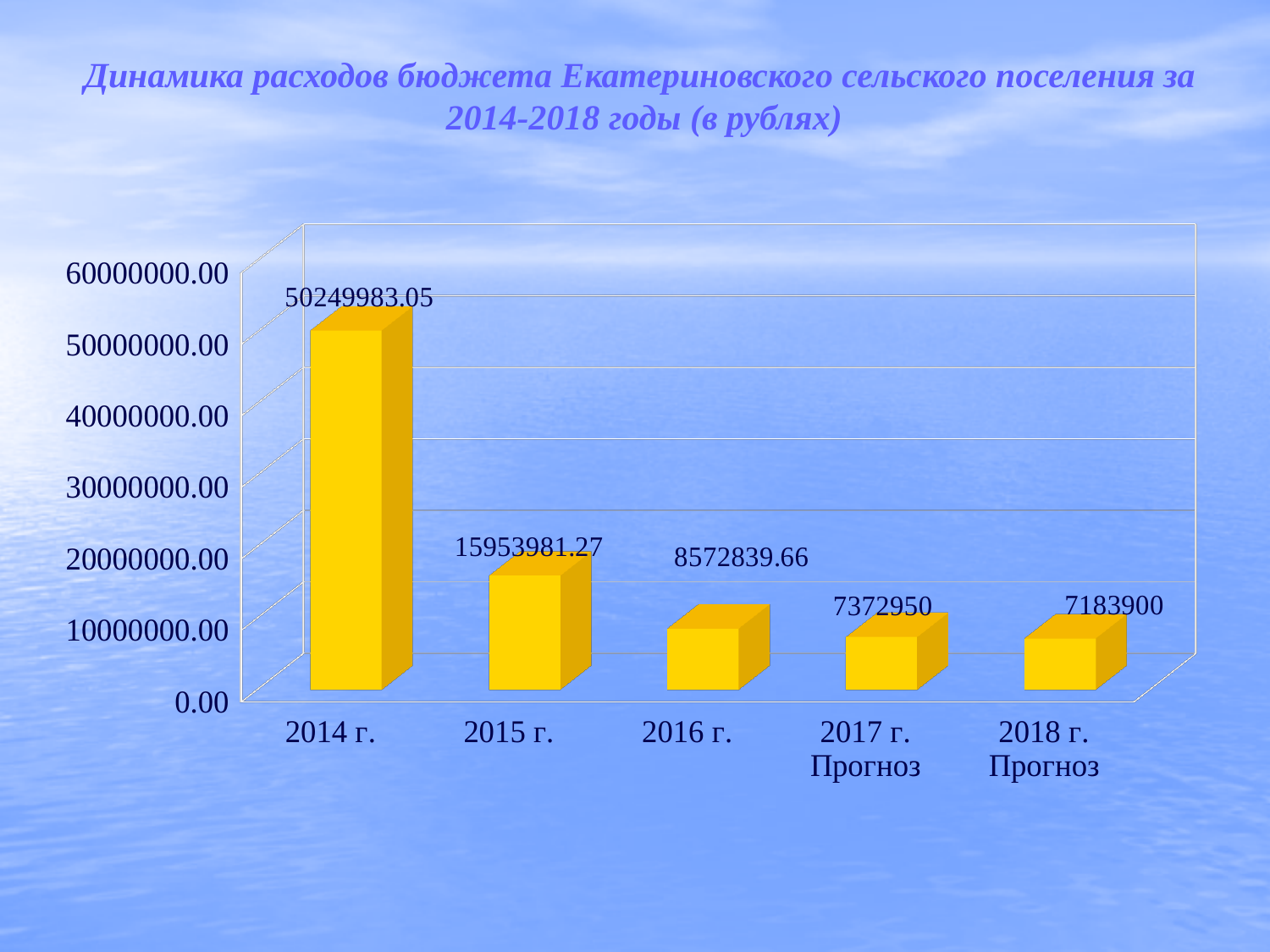
How many years are shown on the x axis? 5 Which year has the lowest value? 2018 г. Прогноз What is the difference between the values for 2014 г. and 2015 г.? 34296001.78 What is the value for 2016 г.? 8572839.66 What is the value for 2015 г.? 15953981.27 Which is larger, the value for 2015 г. or the value for 2016 г.? 2015 г. What is the difference between the values for 2017 г. Прогноз and 2018 г. Прогноз? 189050 Which year has the highest value? 2014 г. Do the values rise or fall from 2014 г. to 2018 г. Прогноз? fall What is the value for 2014 г.? 50249983.05 What is the value for 2018 г. Прогноз? 7183900 What is the value for 2017 г. Прогноз? 7372950